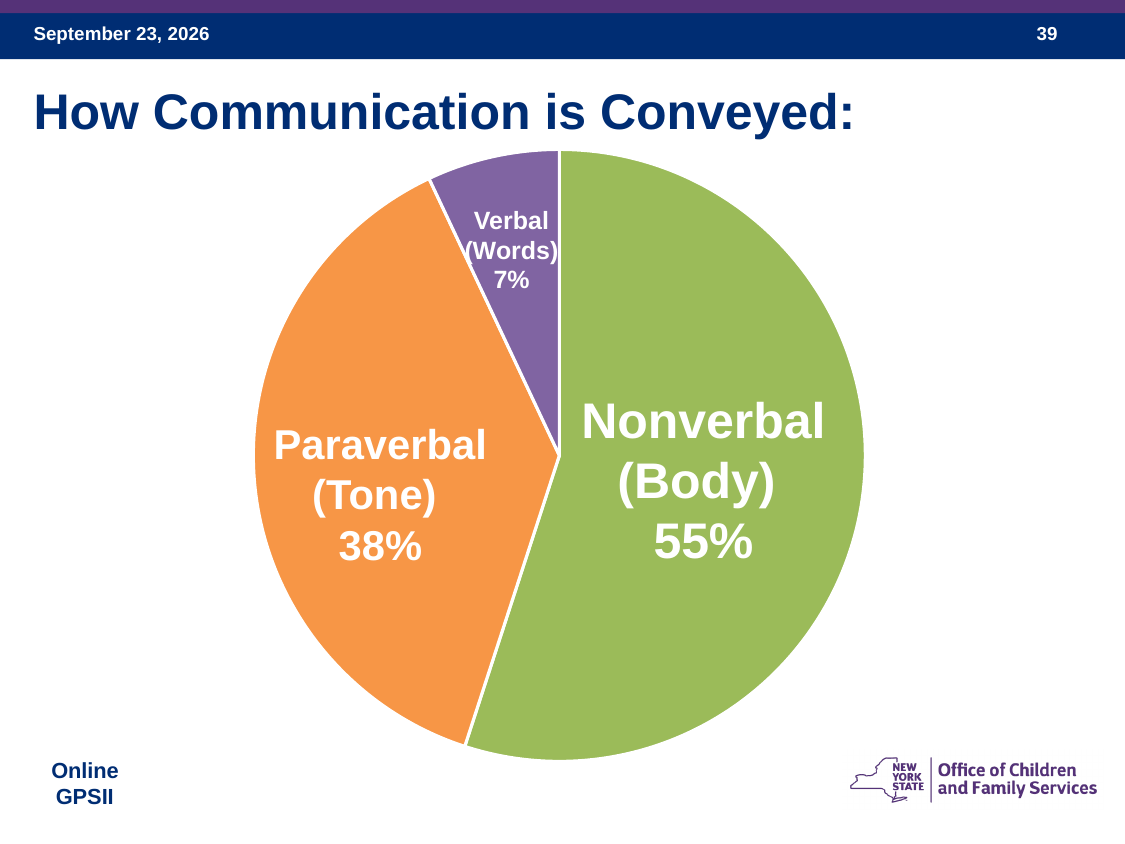
What percentage is shown for Paraverbal (Tone)? 38% How many slices does the pie chart have? 3 What percentage is shown for Verbal (Words)? 7% Which slice of the pie is the smallest? Verbal (Words) What is the difference in percentage points between Paraverbal (Tone) and Verbal (Words)? 31 Which is larger, the share for Paraverbal (Tone) or the share for Verbal (Words)? Paraverbal (Tone) What is the difference in percentage points between Nonverbal (Body) and Paraverbal (Tone)? 17 What percentage is shown for Nonverbal (Body)? 55% Which slice of the pie is the largest? Nonverbal (Body) What colour is the Nonverbal (Body) slice? green What kind of chart is shown on the slide? pie chart What is the title of the slide containing the pie chart? How Communication is Conveyed: